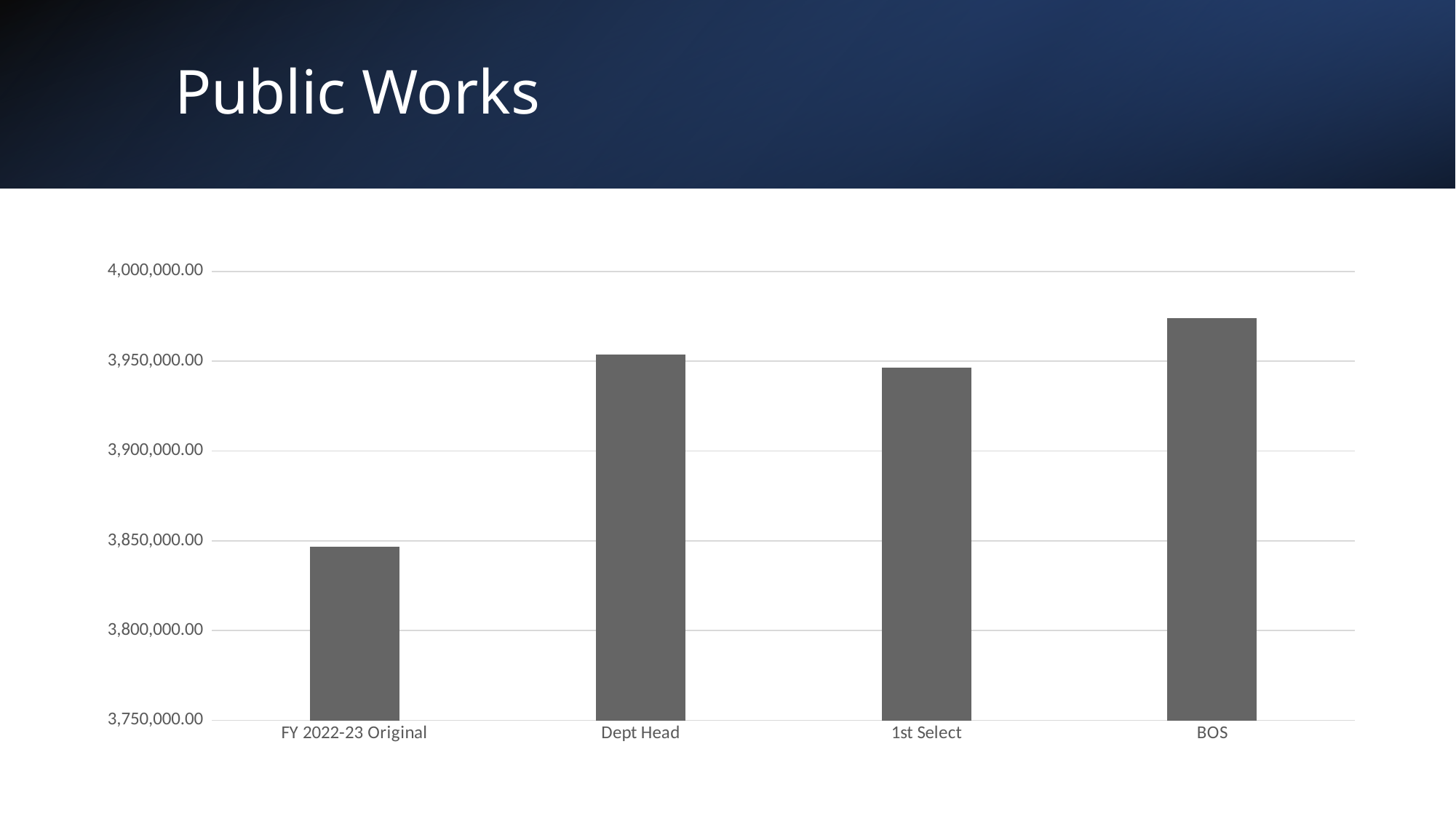
Which category has the highest value? BOS Is the value for Dept Head greater or less than 3,900,000.00? greater Which is larger, the value for FY 2022-23 Original or the value for 1st Select? 1st Select Which is larger, the value for BOS or the value for Dept Head? BOS Is the value for 1st Select greater or less than 3,900,000.00? greater Is the value for BOS greater or less than 4,000,000.00? less How many categories are plotted on the chart? 4 Which category has the lowest value? FY 2022-23 Original What kind of chart is shown on the slide? bar chart What is the title of the slide containing the chart? Public Works